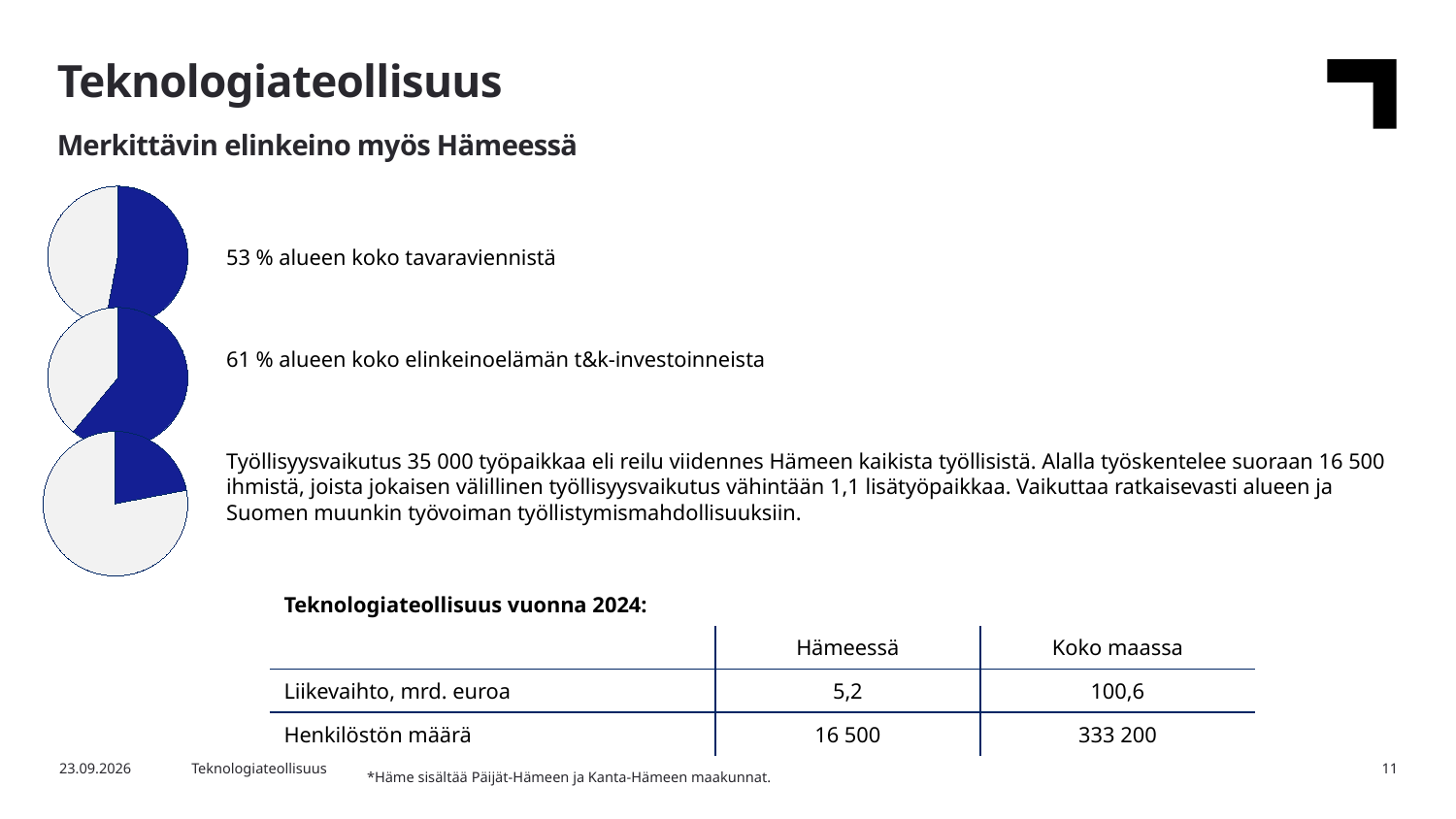
Is the blue slice in the bottom pie chart greater or less than 50% of the pie? less What kind of chart is used on the left side of the slide? Pie chart In the middle pie chart, what share of the region's business R&D investments (t&k-investoinnit) does the blue slice represent? 61 % What is the difference in percentage points between the blue slice of the middle pie chart (61 %) and the blue slice of the top pie chart (53 %)? 8 percentage points What colour is used for the highlighted slice in the pie charts? Blue In the top pie chart, what share of the region's total goods exports (tavaravienti) does the blue slice represent? 53 % Is the blue slice in the middle pie chart greater or less than 50% of the pie? greater Which pie chart has the smallest blue slice: the top, middle or bottom one? Bottom How many pie charts are shown on the slide? 3 How many slices does each pie chart have? 2 Which blue slice is larger: the one in the top pie chart (goods exports) or the one in the middle pie chart (R&D investments)? Middle pie chart (R&D investments) Which pie chart has the largest blue slice: the top, middle or bottom one? Middle